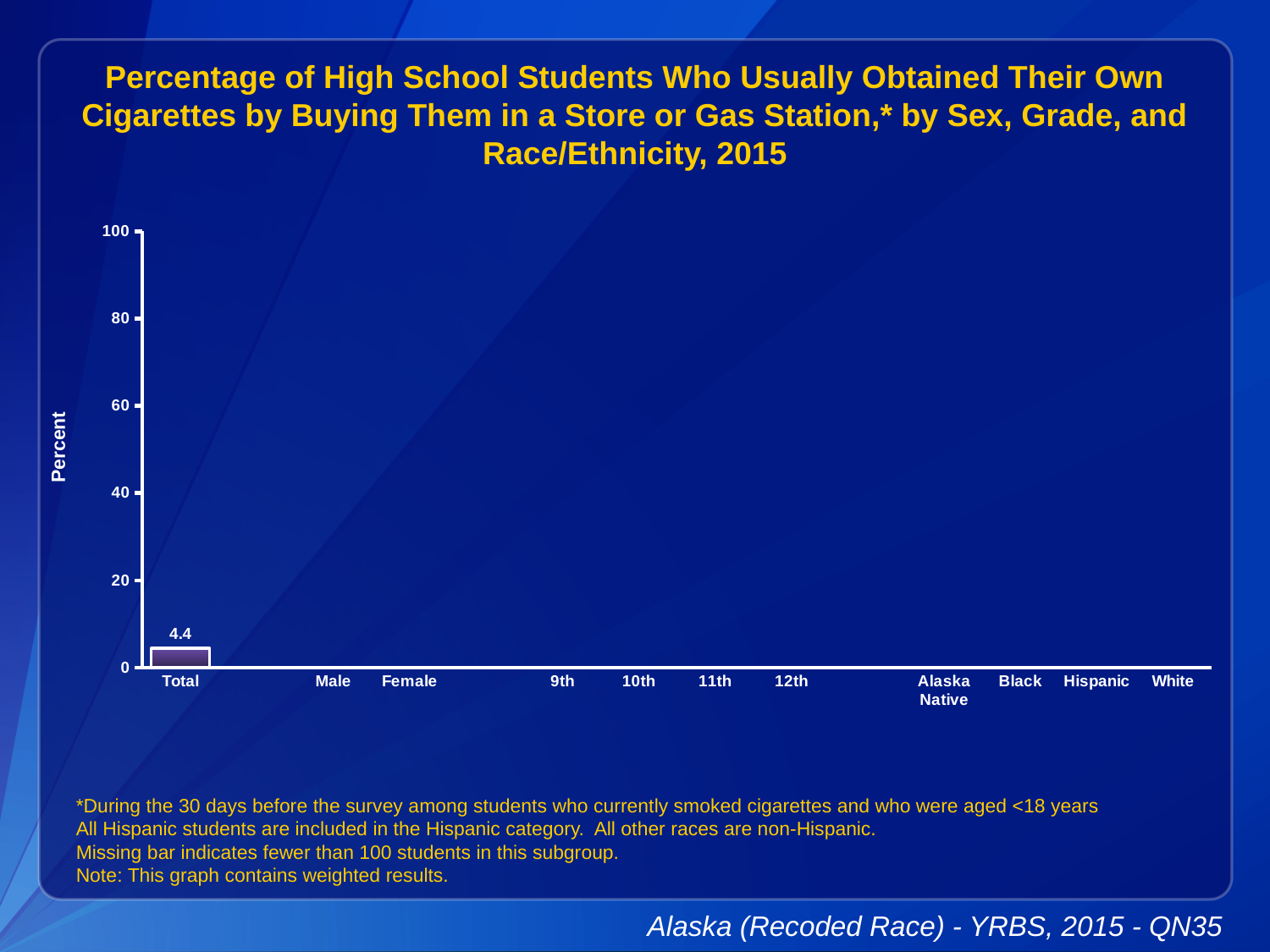
How many bars are actually plotted on the chart? 1 What is the label on the y axis? Percent According to the note on the slide, what does a missing bar indicate? Fewer than 100 students in this subgroup What is the value for Total? 4.4 What is the highest tick value shown on the y axis? 100 Is the value for Total greater or less than 20? less Which category is the only one with a plotted bar? Total Is the value for Total greater or less than 40? less What kind of chart is shown on the slide? bar chart How many category labels are shown along the x axis? 11